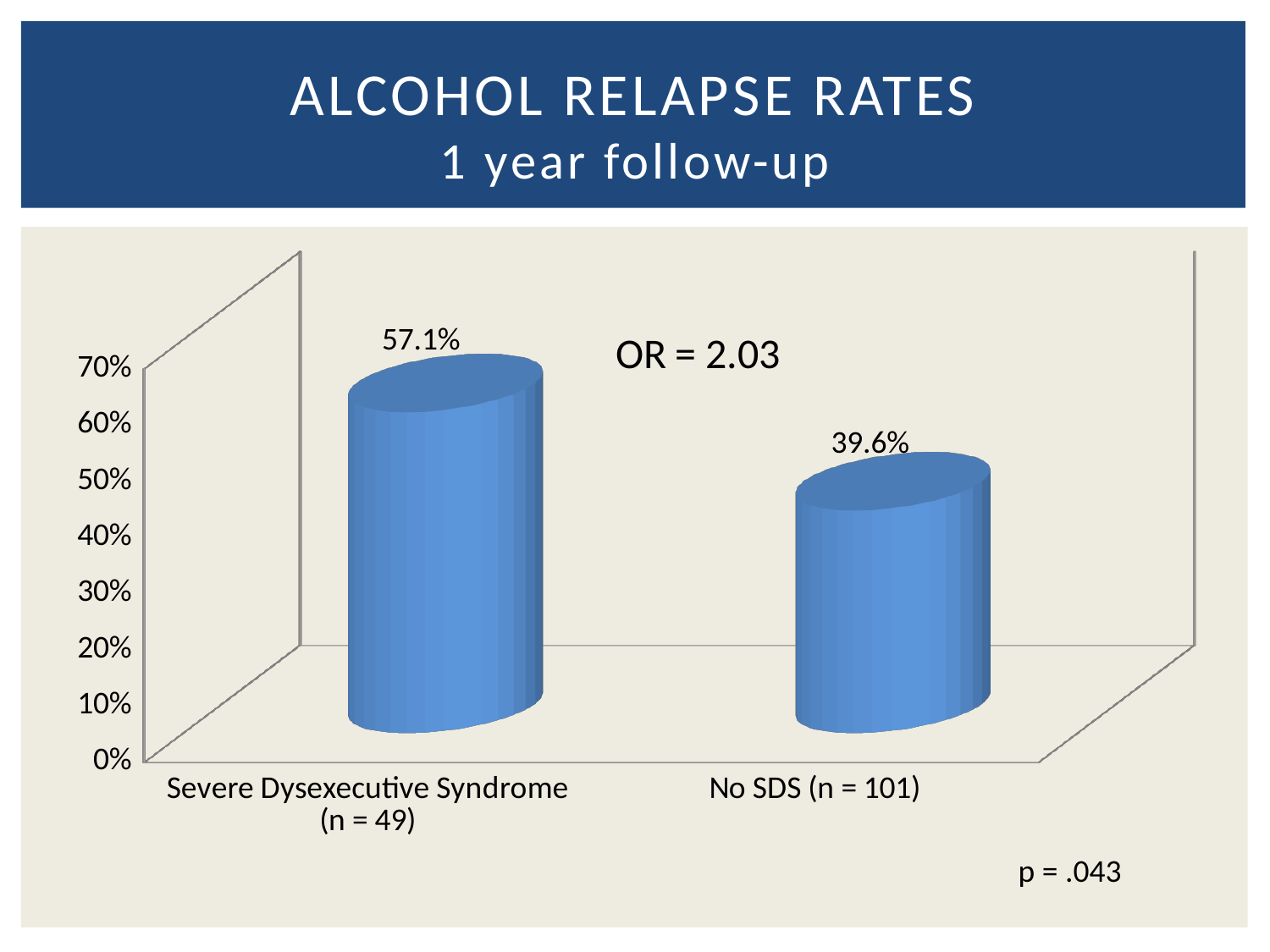
What is the sample size of the Severe Dysexecutive Syndrome group? 49 Is the relapse rate for the No SDS group greater or less than 50%? less What is the difference in relapse rate between the Severe Dysexecutive Syndrome group and the No SDS group? 17.5% What is the alcohol relapse rate for the Severe Dysexecutive Syndrome group? 57.1% How many groups are shown in the chart? 2 What odds ratio is shown on the chart? 2.03 What is the alcohol relapse rate for the No SDS group? 39.6% Which group has the higher relapse rate? Severe Dysexecutive Syndrome Is the relapse rate higher for the Severe Dysexecutive Syndrome group or the No SDS group? Severe Dysexecutive Syndrome What kind of chart is shown on the slide? bar chart Which group has the lower relapse rate? No SDS